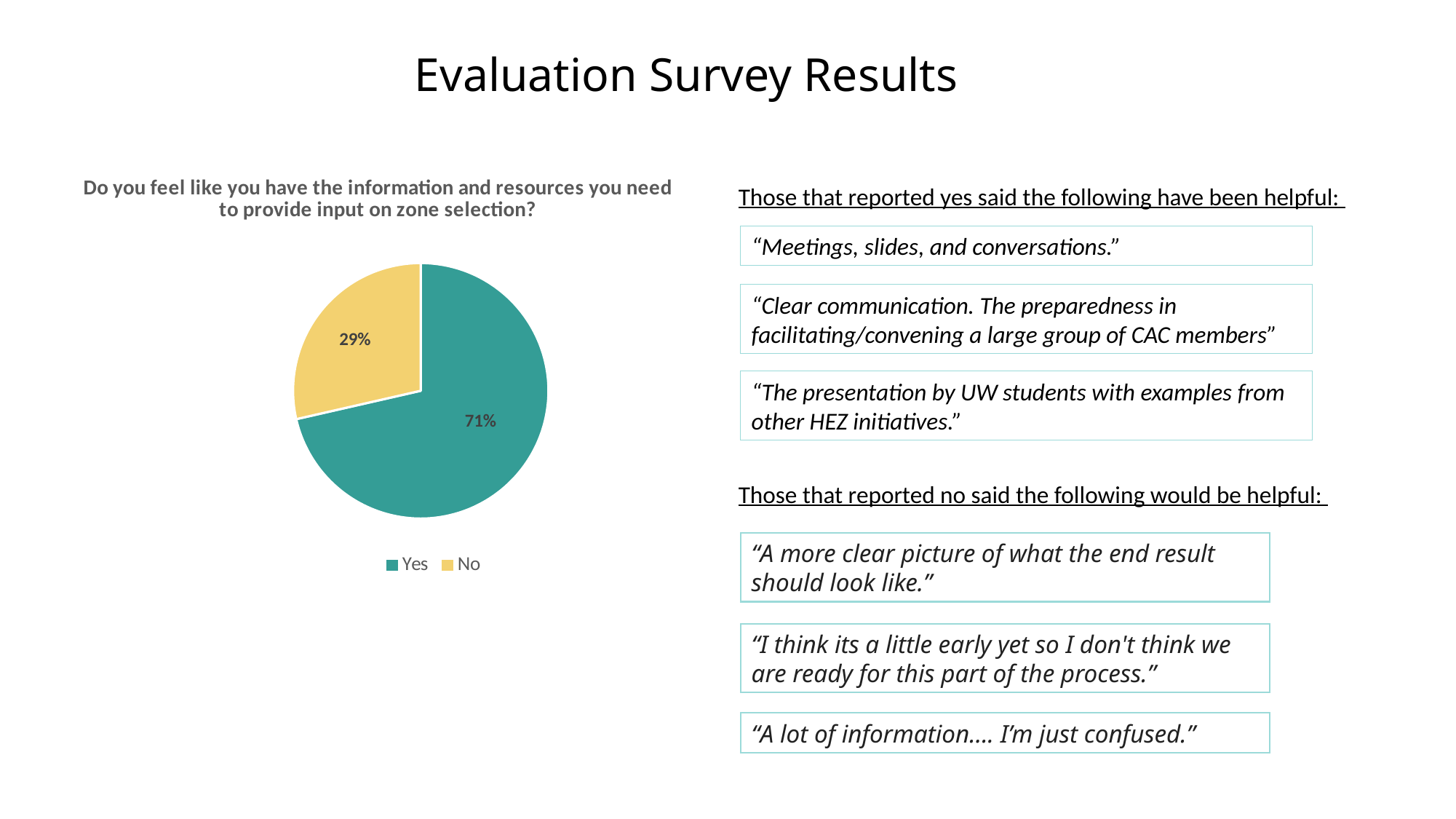
What is the title of the pie chart? Do you feel like you have the information and resources you need to provide input on zone selection? How many entries does the legend list? 2 Which response has the smaller share of the pie? No How many slices does the pie chart have? 2 What percentage of respondents answered No? 29% What kind of chart is shown on the slide? pie chart Is the share for Yes larger or smaller than the share for No? larger What is the difference in percentage points between the Yes and No shares? 42 What colour is the Yes slice of the pie chart? teal Which response has the larger share of the pie? Yes What percentage of respondents answered Yes? 71%